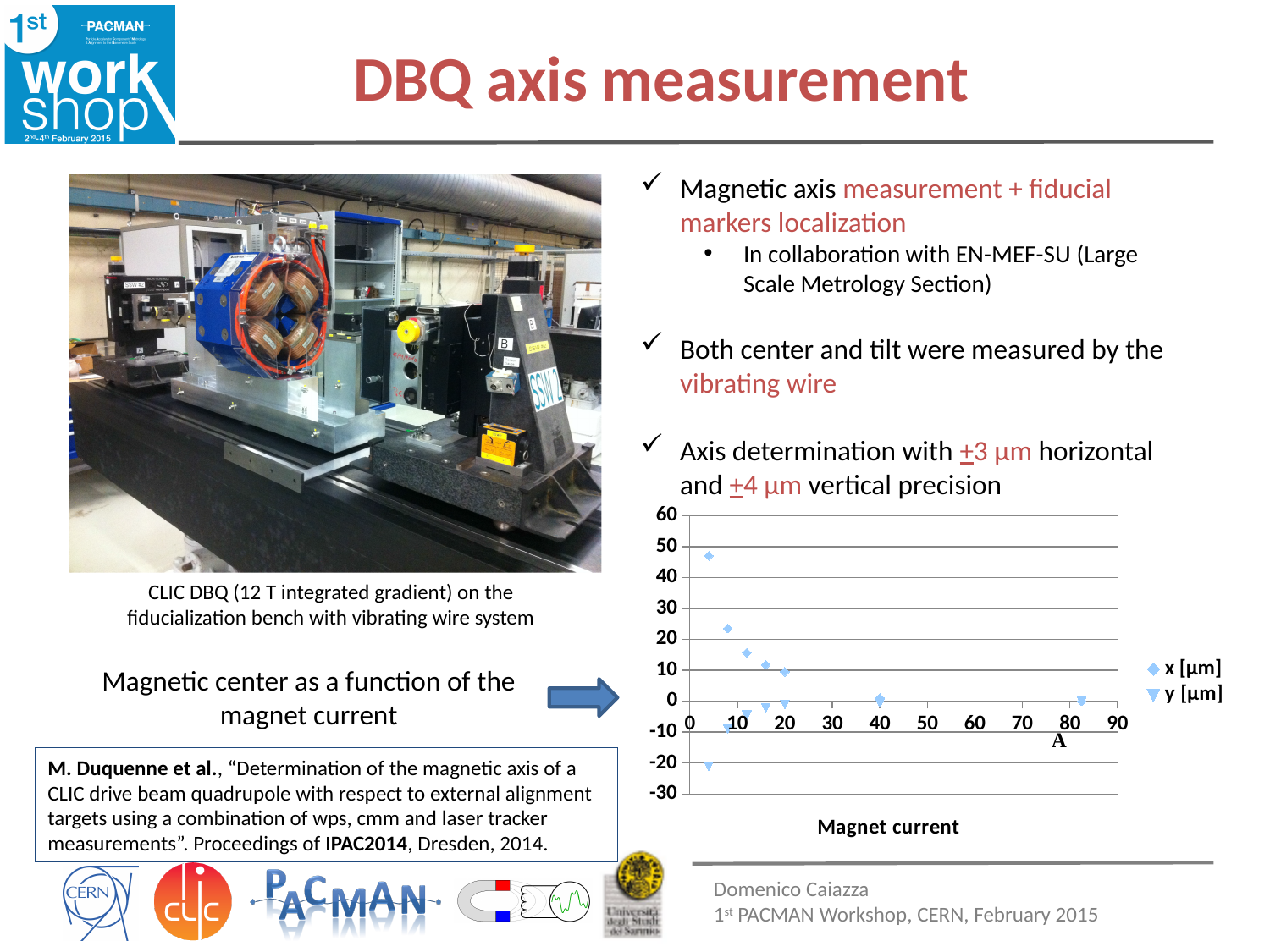
At the lowest magnet current, which series has the larger value, x [μm] or y [μm]? x [μm] How many data points are plotted for the x [μm] series? 7 Is the y [μm] value at the lowest magnet current greater or less than -10? less Do the y [μm] values rise or fall as the magnet current increases? rise Is the x [μm] value at about 40 A greater or less than 20? less What kind of chart is shown on the slide? scatter chart Is the x [μm] value at the lowest magnet current greater or less than 40? greater Do the x [μm] values rise or fall as the magnet current increases? fall What is the highest tick value shown on the vertical axis of the chart? 60 What are the two series named in the chart legend? x [μm] and y [μm] What is the title of the horizontal axis of the chart? Magnet current How many series does the chart legend list? 2